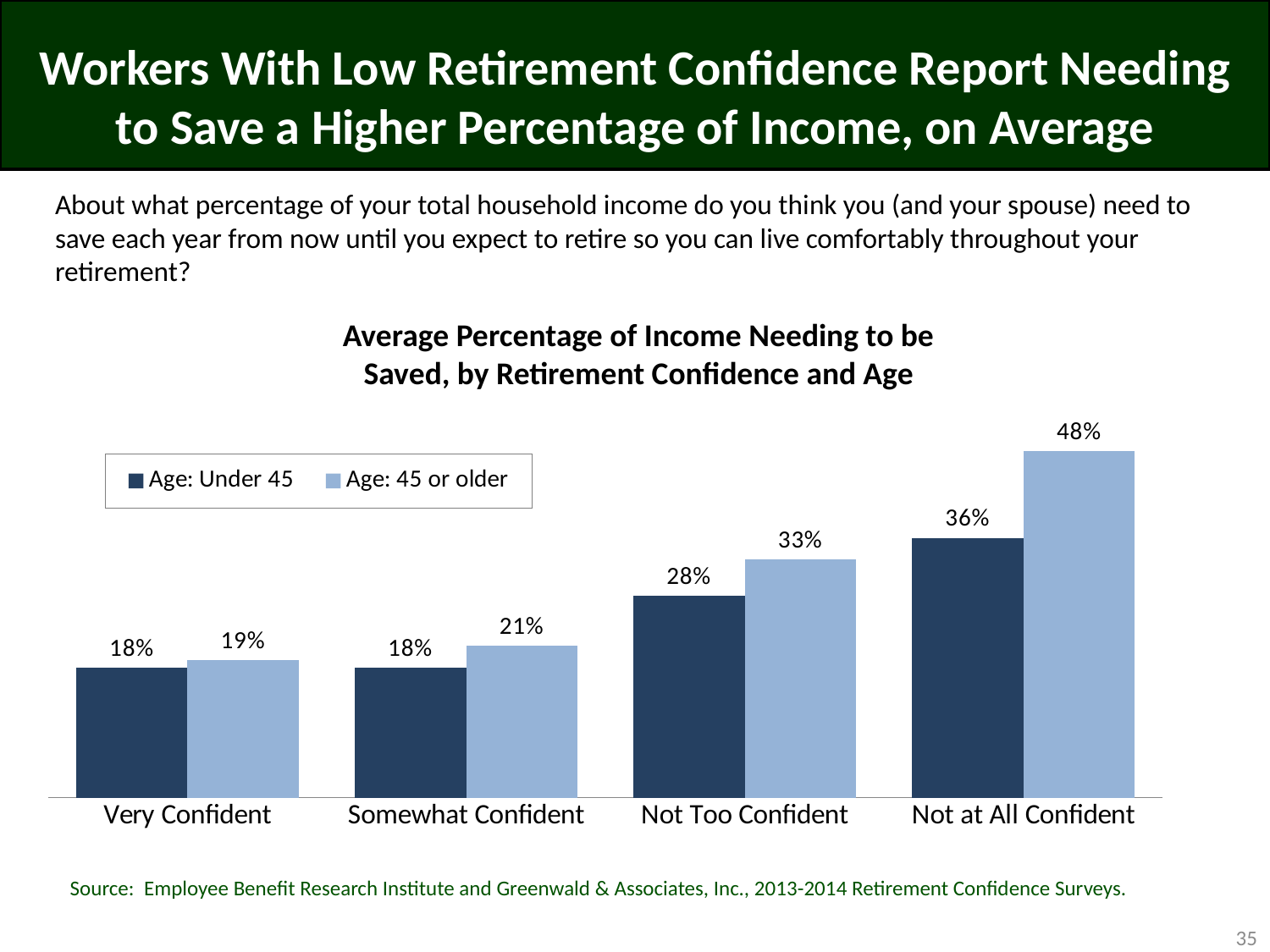
How many series does the legend list? 2 Which category has the lowest value for Age: 45 or older? Very Confident Which category has the highest value for Age: Under 45? Not at All Confident What kind of chart is shown on the slide? Bar chart What is the difference between the Age: Under 45 values for Not Too Confident and Very Confident? 10% How many categories are shown on the x axis? 4 What is the difference between the Age: 45 or older and Age: Under 45 values in the Not at All Confident category? 12% Which is larger: the Age: 45 or older value for Not Too Confident or the Age: Under 45 value for Not at All Confident? Age: Under 45 value for Not at All Confident What is the value for Age: 45 or older in the Somewhat Confident category? 21% What is the value for Age: Under 45 in the Not Too Confident category? 28% Do the Age: 45 or older values rise or fall from Very Confident to Not at All Confident? Rise What is the value for Age: 45 or older in the Not at All Confident category? 48%